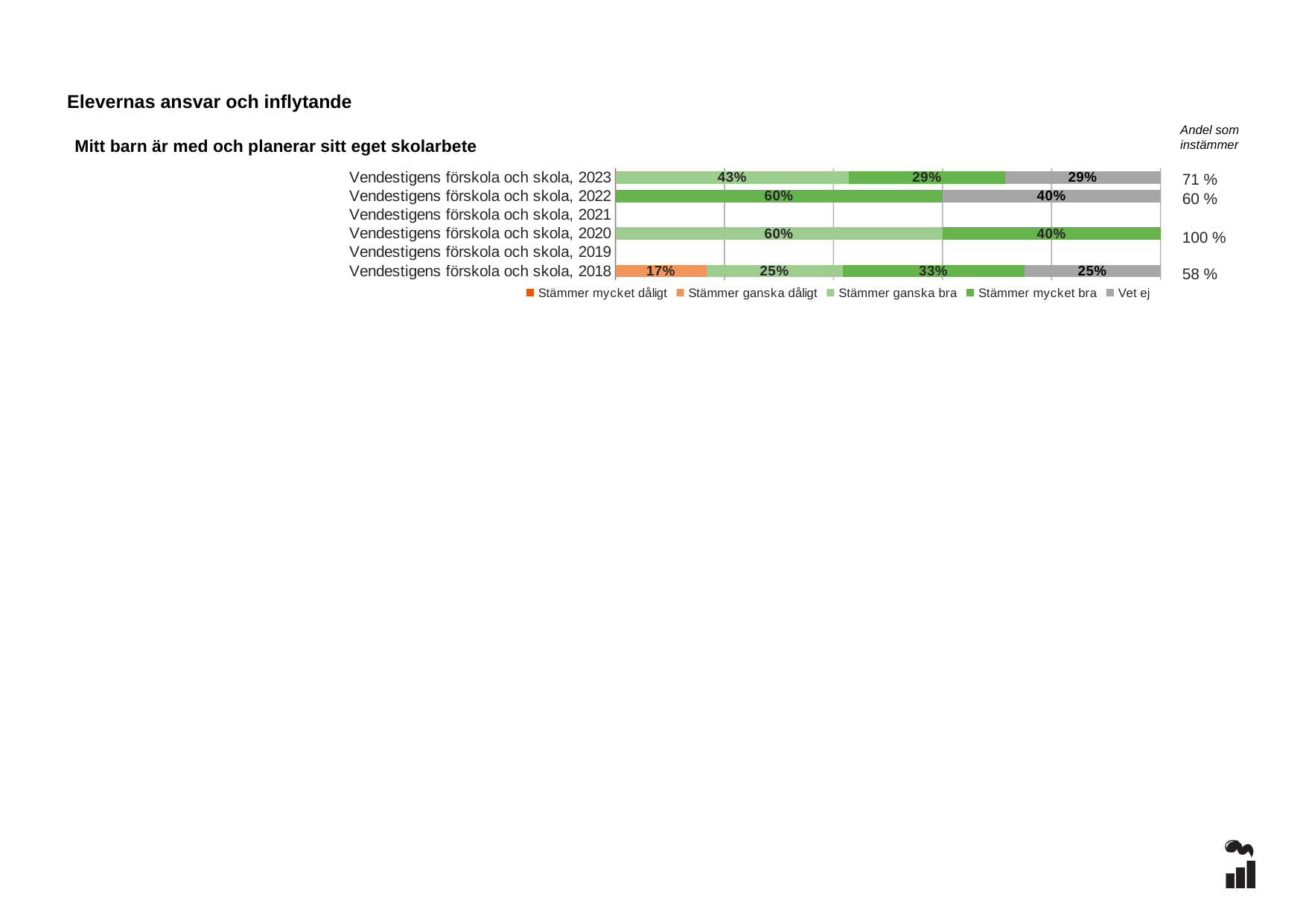
What is the value of 'Stämmer ganska dåligt' for Vendestigens förskola och skola, 2018? 17% How many series does the legend list? 5 What is the title of the chart? Mitt barn är med och planerar sitt eget skolarbete What kind of chart is shown on the slide? Stacked bar chart What is the value of 'Vet ej' for Vendestigens förskola och skola, 2022? 40% Which is larger: 'Stämmer mycket bra' for 2018 or 'Stämmer mycket bra' for 2023? 2018 What is the difference between the 'Stämmer mycket bra' values for 2022 and 2023? 31 percentage points What is the value of 'Stämmer mycket bra' for Vendestigens förskola och skola, 2020? 40% Which year has the highest 'Andel som instämmer' value? 2020 What is the value of 'Stämmer ganska bra' for Vendestigens förskola och skola, 2023? 43% What is the 'Andel som instämmer' value shown for Vendestigens förskola och skola, 2023? 71 % Which year has the lowest 'Andel som instämmer' value? 2018